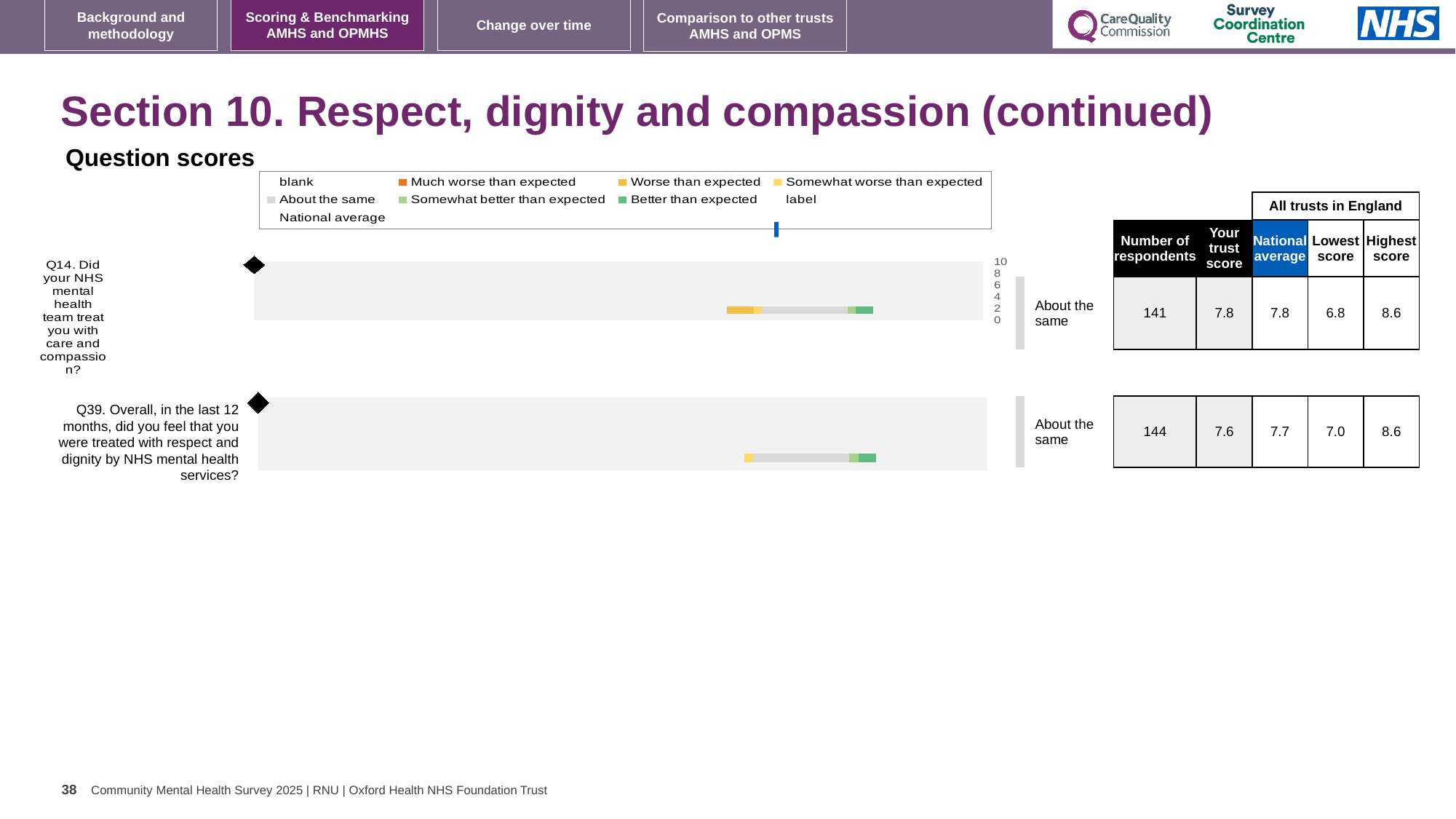
What is your trust score for Q39? 7.6 How many questions are plotted in the question scores charts? 2 What is the number of respondents for Q39? 144 What is the number of respondents for Q14? 141 What is the national average for Q39? 7.7 What is your trust score for Q14? 7.8 What is the difference between the highest score and the lowest score for Q39? 1.6 What kind of chart is used to show the question scores for Q14 and Q39? bar chart What is the highest score among all trusts in England for Q39? 8.6 What benchmark category is shown for Q14? About the same Which question has the higher trust score, Q14 or Q39? Q14 What is the lowest score among all trusts in England for Q14? 6.8